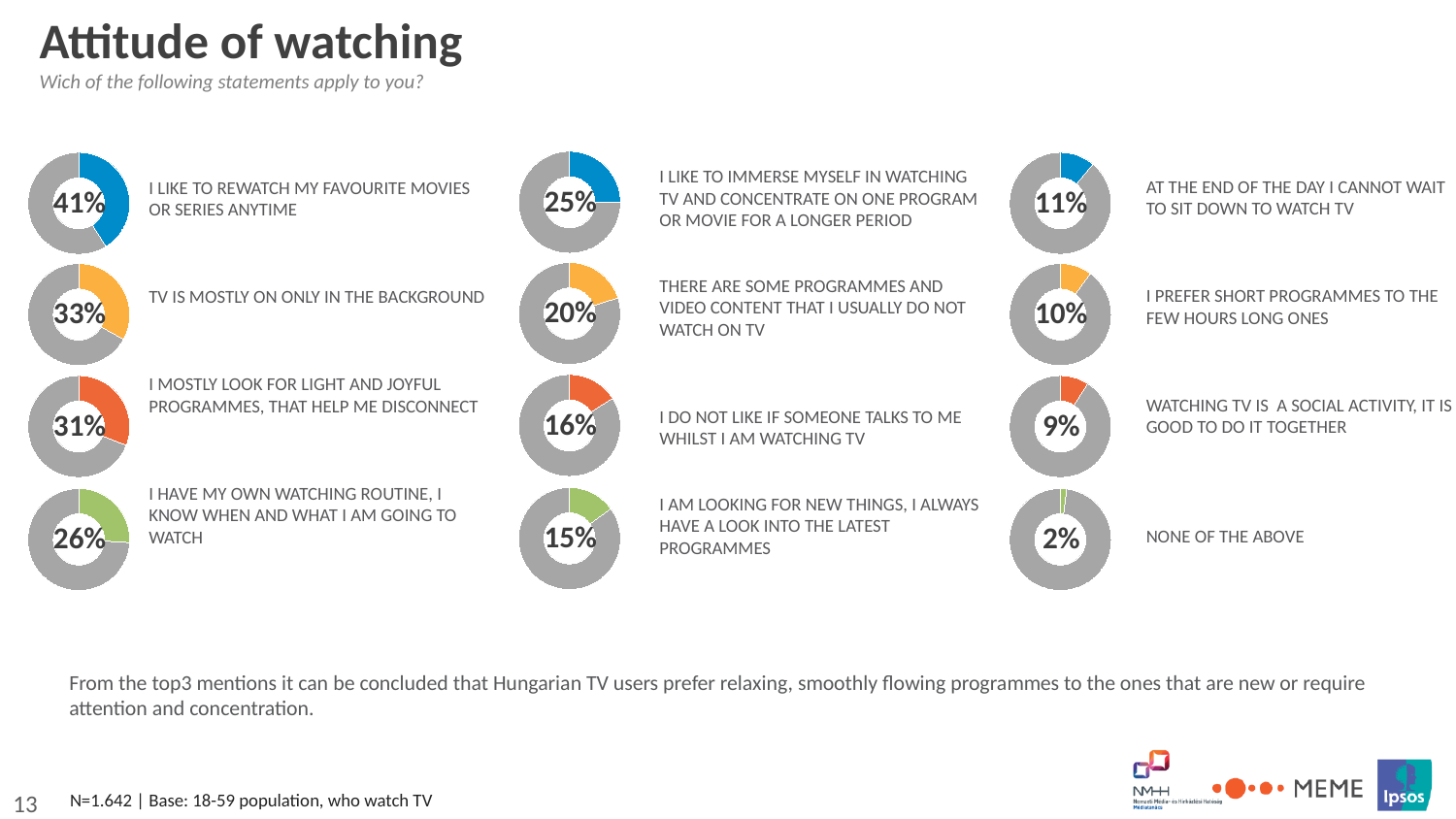
Which has a higher percentage: "I do not like if someone talks to me whilst I am watching TV" or "I am looking for new things, I always have a look into the latest programmes"? I do not like if someone talks to me whilst I am watching TV Across all the donut charts on the slide, which statement has the highest percentage? I like to rewatch my favourite movies or series anytime What type of chart is used to display each percentage on the slide? Donut (pie) chart What is the title of the slide containing the donut charts? Attitude of watching Across all the donut charts on the slide, which statement has the lowest percentage? None of the above What percentage is shown in the donut chart for the statement "TV is mostly on only in the background"? 33% How many donut charts are shown on the slide? 12 What percentage is shown in the donut chart for the statement "I prefer short programmes to the few hours long ones"? 10% What is the difference between the percentage for "At the end of the day I cannot wait to sit down to watch TV" and the percentage for "Watching TV is a social activity, it is good to do it together"? 2% What is the difference between the percentage for "I like to rewatch my favourite movies or series anytime" and the percentage for "TV is mostly on only in the background"? 8% What percentage is shown in the donut chart for "None of the above"? 2% What percentage is shown in the donut chart for the statement "I like to rewatch my favourite movies or series anytime"? 41%